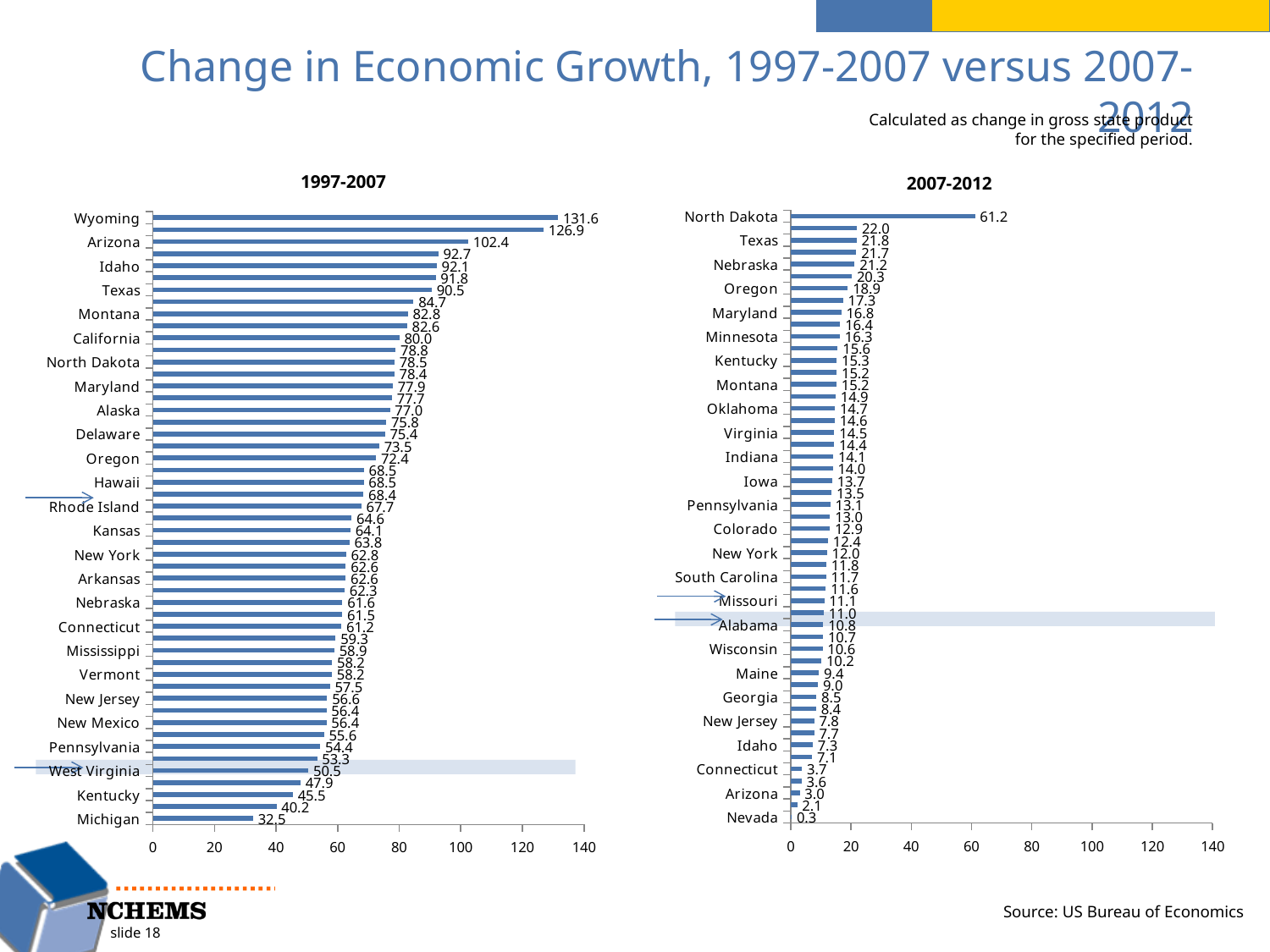
Which is larger: Texas's value in the 1997-2007 chart or Texas's value in the 2007-2012 chart? 1997-2007 In the 2007-2012 chart, is the value for North Dakota greater or less than 40? greater What type of chart is used for the 1997-2007 data on the left? bar chart In the 1997-2007 chart, which state has the highest value? Wyoming In the 2007-2012 chart, what is the value for North Dakota? 61.2 In the 2007-2012 chart, which state has the lowest value? Nevada In the 1997-2007 chart, what is the difference between Wyoming's value and Michigan's value? 99.1 In the 1997-2007 chart, which state has the lowest value? Michigan In the 1997-2007 chart, what is the value for Michigan? 32.5 In the 2007-2012 chart, which state has the highest value? North Dakota In the 1997-2007 chart, what is the value for Wyoming? 131.6 What is the maximum value shown on the horizontal axis of the 2007-2012 chart? 140